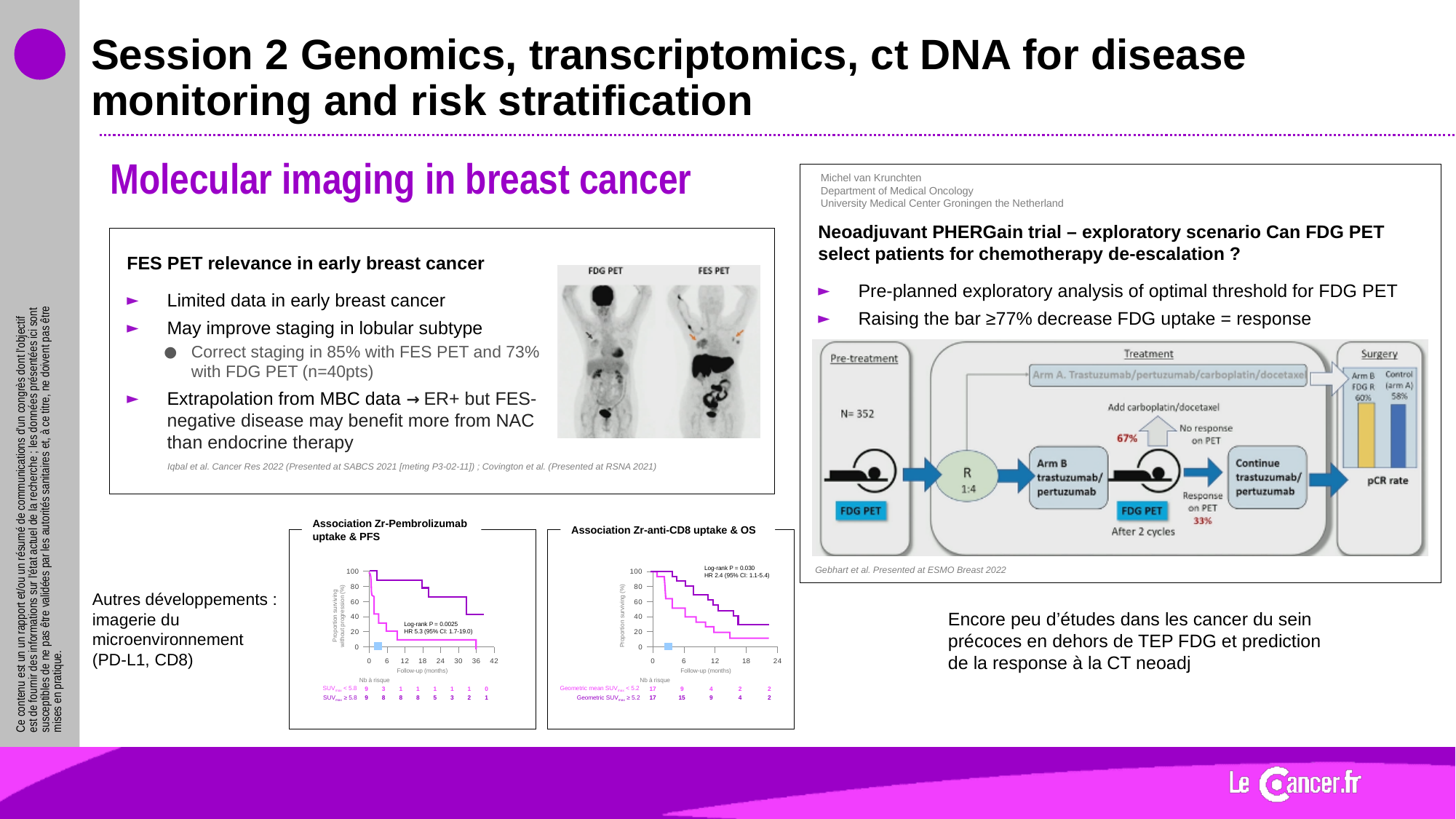
In the pCR rate bar chart of the PHERGain diagram, what is the pCR rate for Arm B FDG R? 60% In the 'Association Zr-anti-CD8 uptake & OS' chart, how many patients with Geometric mean SUVmax ≥ 5.2 are at risk at 6 months? 15 How many patient groups (curves) are plotted in the 'Association Zr-Pembrolizumab uptake & PFS' chart? 2 What kind of chart shows the pCR rate in the PHERGain diagram? Bar chart In the 'Association Zr-anti-CD8 uptake & OS' chart, what hazard ratio (HR) is shown? 2.4 (95% CI: 1.1-5.4) In the pCR rate bar chart of the PHERGain diagram, what is the difference between the Arm B FDG R and Control (arm A) pCR rates? 2% In the 'Association Zr-Pembrolizumab uptake & PFS' chart, how many patients with SUVmax ≥ 5.8 are at risk at 24 months? 5 In the 'Association Zr-anti-CD8 uptake & OS' chart, do the survival curves rise or fall as follow-up time increases? Fall In the pCR rate bar chart of the PHERGain diagram, what is the pCR rate for Control (arm A)? 58% In the 'Association Zr-Pembrolizumab uptake & PFS' chart, what is the log-rank P value shown? 0.0025 In the 'Association Zr-Pembrolizumab uptake & PFS' chart, how many patients with SUVmax < 5.8 are at risk at 6 months? 3 In the pCR rate bar chart of the PHERGain diagram, which arm has the higher pCR rate, Arm B FDG R or Control (arm A)? Arm B FDG R